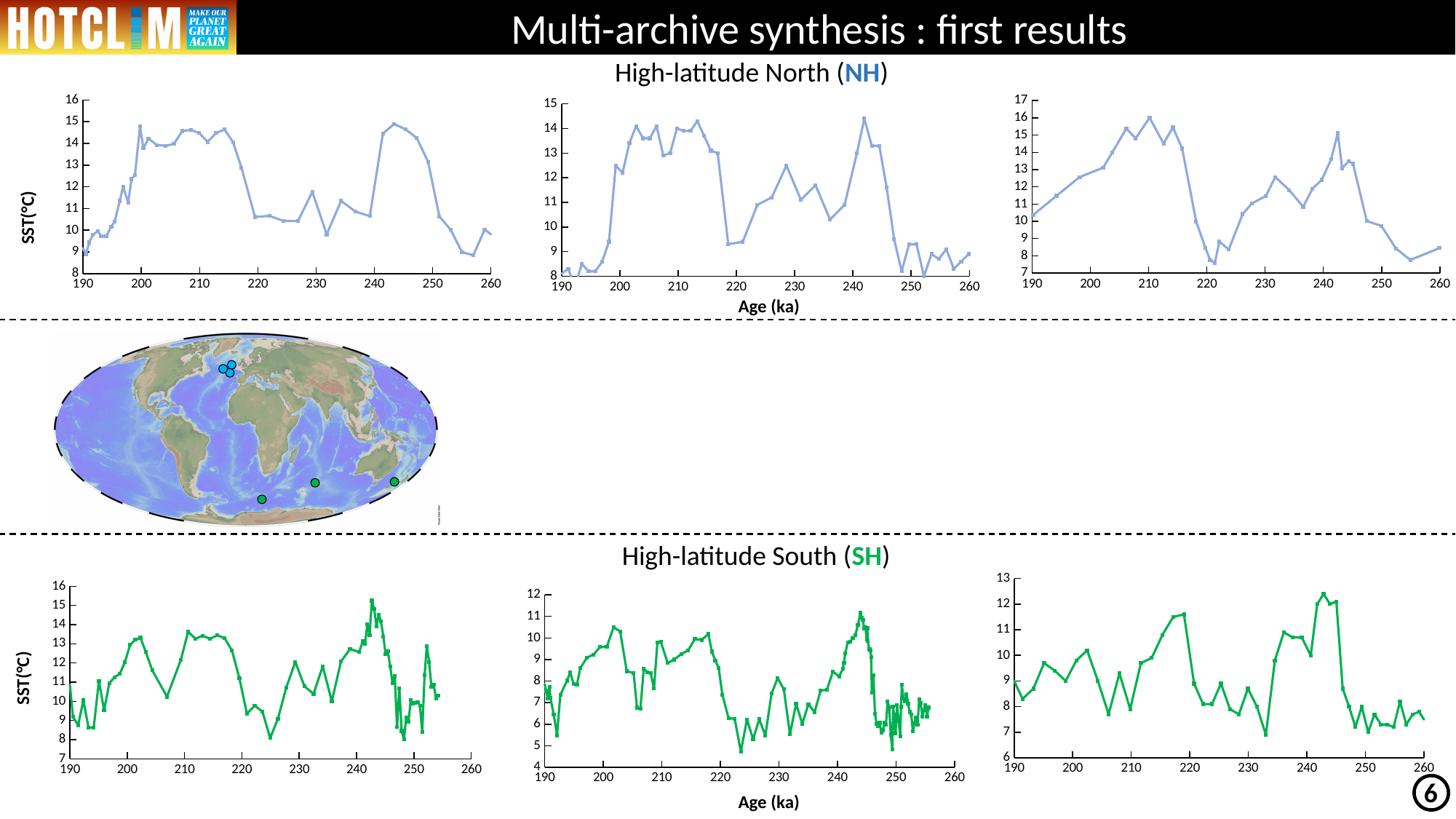
In the leftmost High-latitude North (NH) chart, is the value at 255 ka greater or less than 10? less What is the x-axis label shown under the middle High-latitude South (SH) chart? Age (ka) In the rightmost High-latitude North (NH) chart, is the value at 210 ka greater or less than 14? greater In the middle High-latitude South (SH) chart, is the value at 223 ka greater or less than 6? less What kind of chart is the leftmost chart in the High-latitude North (NH) row? line chart How many charts are shown in the High-latitude South (SH) row? 3 What is the y-axis label of the leftmost High-latitude North (NH) chart? SST(°C) In the leftmost High-latitude North (NH) chart, does the line rise or fall between 190 ka and 200 ka? rise